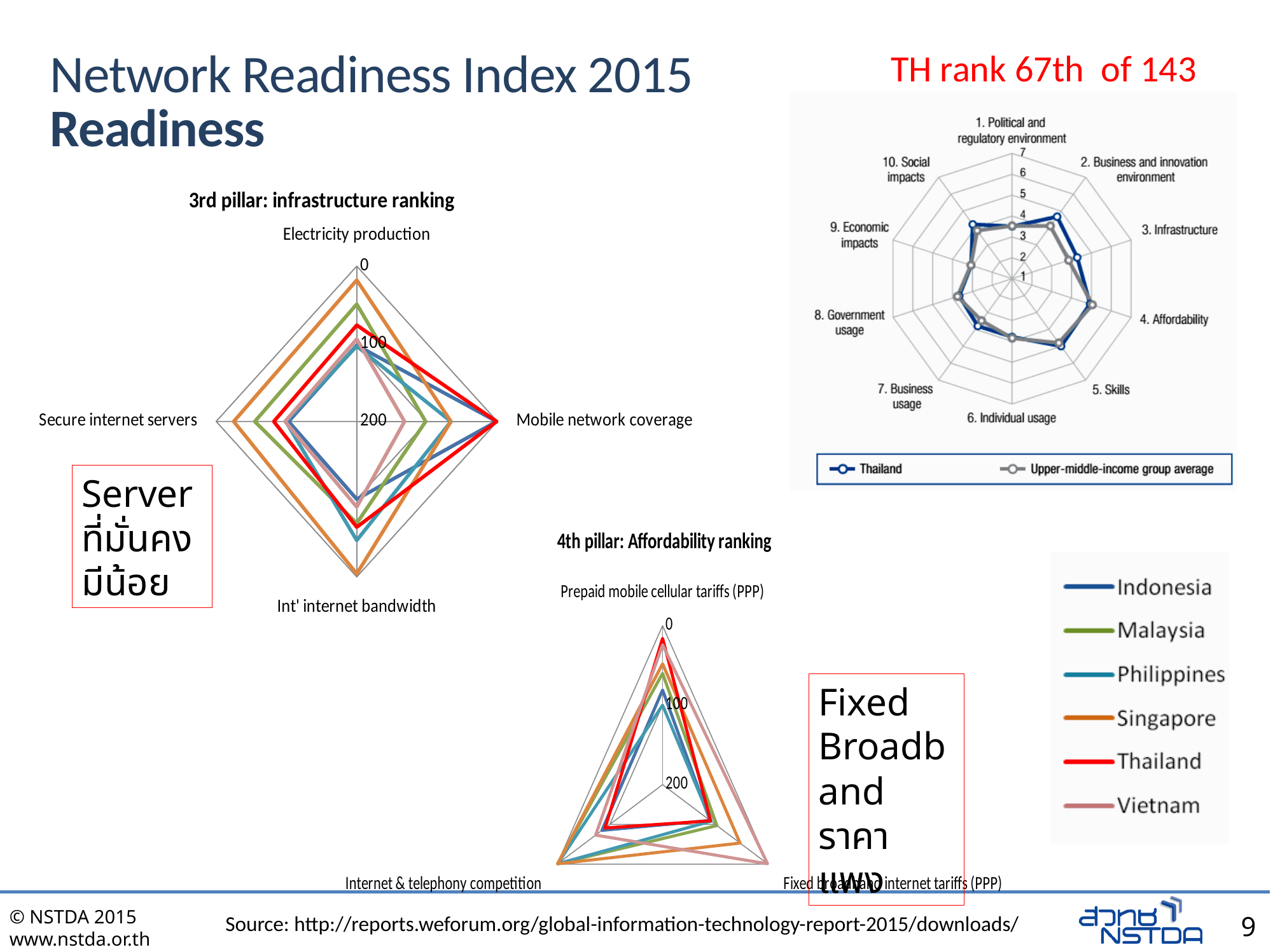
How many axes (pillars) does the top-right radar chart comparing Thailand with the upper-middle-income group average have? 10 What kind of chart is the '3rd pillar: infrastructure ranking' chart? Radar chart In the '4th pillar: Affordability ranking' chart, is Vietnam's rank for Fixed broadband internet tariffs (PPP) greater or less than 100? less In the '4th pillar: Affordability ranking' chart, is Thailand's rank for Prepaid mobile cellular tariffs (PPP) greater or less than 100? less How many axes (categories) does the '3rd pillar: infrastructure ranking' chart have? 4 In the legend for the pillar ranking charts, which country is shown in red? Thailand How many axes (categories) does the '4th pillar: Affordability ranking' chart have? 3 In the '3rd pillar: infrastructure ranking' chart, is Singapore's rank for Int' internet bandwidth greater or less than 100? less How many series does the legend of the top-right radar chart (Thailand vs group average) list? 2 How many countries does the legend on the right list for the pillar ranking charts? 6 What is the title of the radar chart in the lower middle of the slide? 4th pillar: Affordability ranking